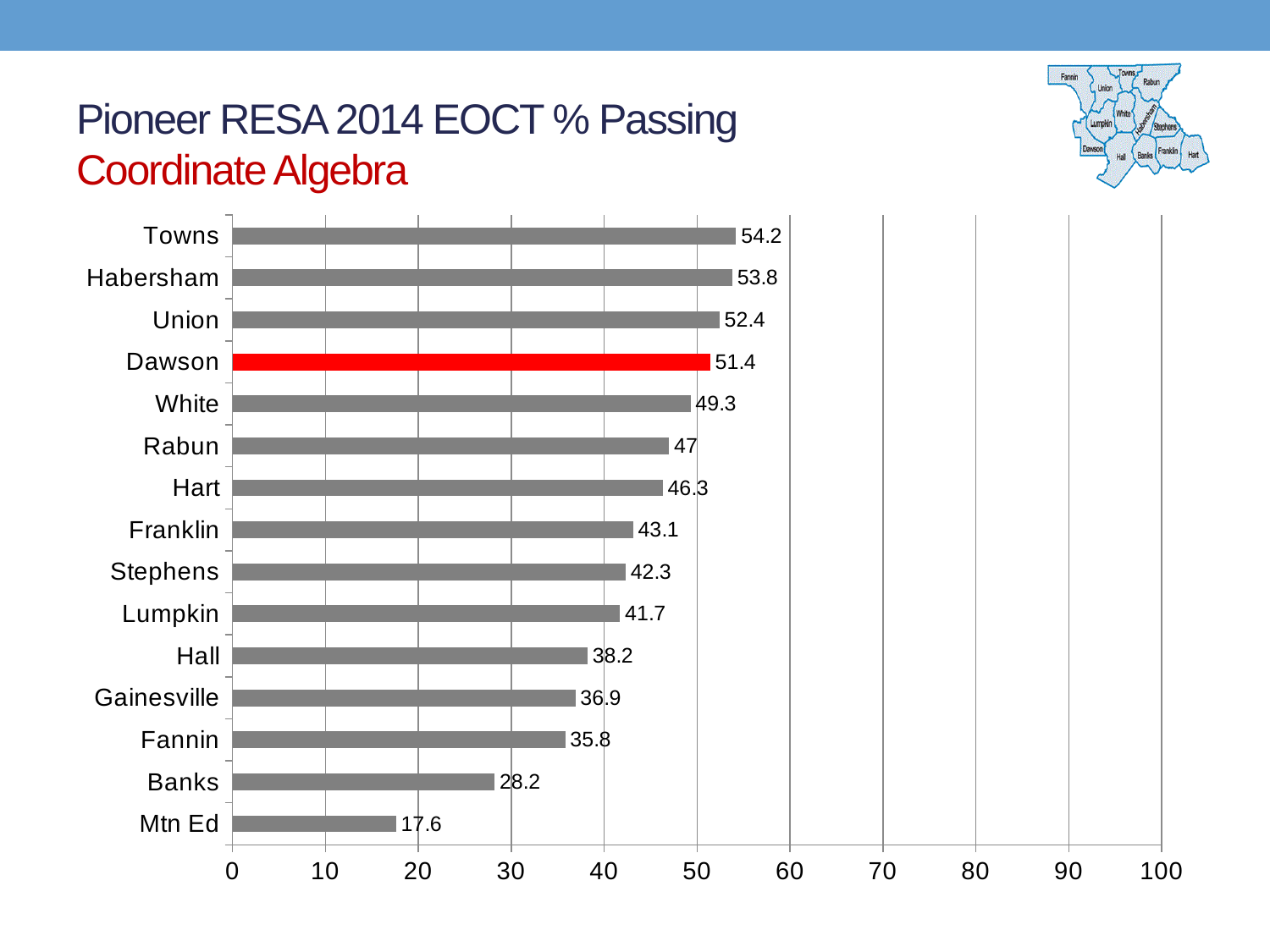
Is the value for Fannin greater or less than 40? less What is the value for Rabun? 47 What is the value for Dawson? 51.4 Which category has the highest value? Towns Which category has the lowest value? Mtn Ed What is the difference between the values for Towns and Mtn Ed? 36.6 How many categories are shown on the chart? 15 What is the difference between the values for Dawson and White? 2.1 What kind of chart is shown on the slide? bar chart What is the value for Mtn Ed? 17.6 Which is larger, the value for Hall or the value for Banks? Hall Which bar is coloured red rather than grey? Dawson